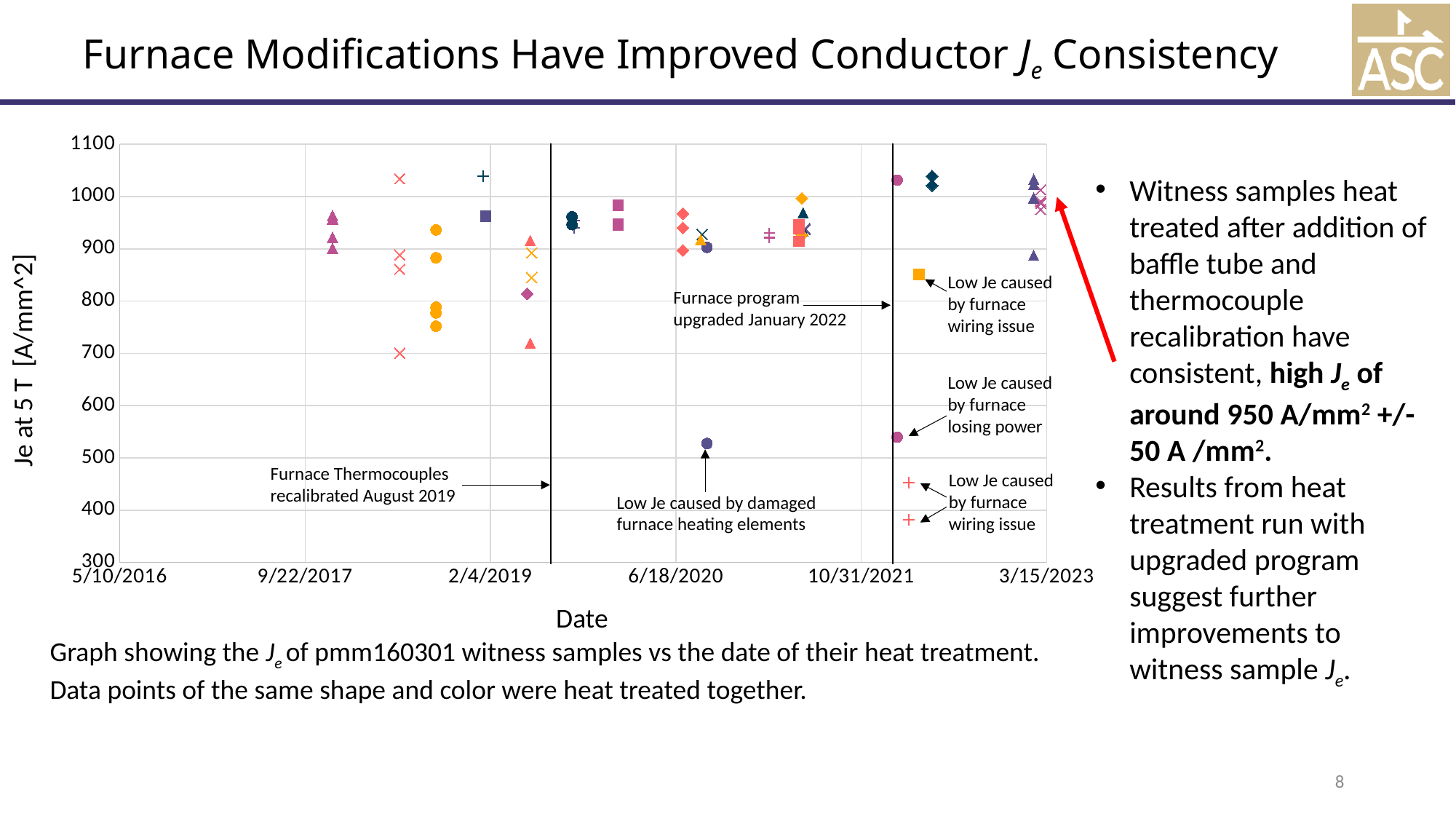
What is the title of the y axis of the chart? Je at 5 T [A/mm^2] Are the two red plus-sign points labelled "Low Je caused by furnace wiring issue" greater or less than 500? less Is the value of the point labelled "Low Je caused by damaged furnace heating elements" greater or less than 600? less According to the chart annotation, what happened in August 2019? Furnace Thermocouples recalibrated Is the value of the point labelled "Low Je caused by damaged furnace heating elements" greater or less than 500? greater How many vertical event lines are drawn on the chart? 2 What kind of chart is shown on the slide? Scatter chart